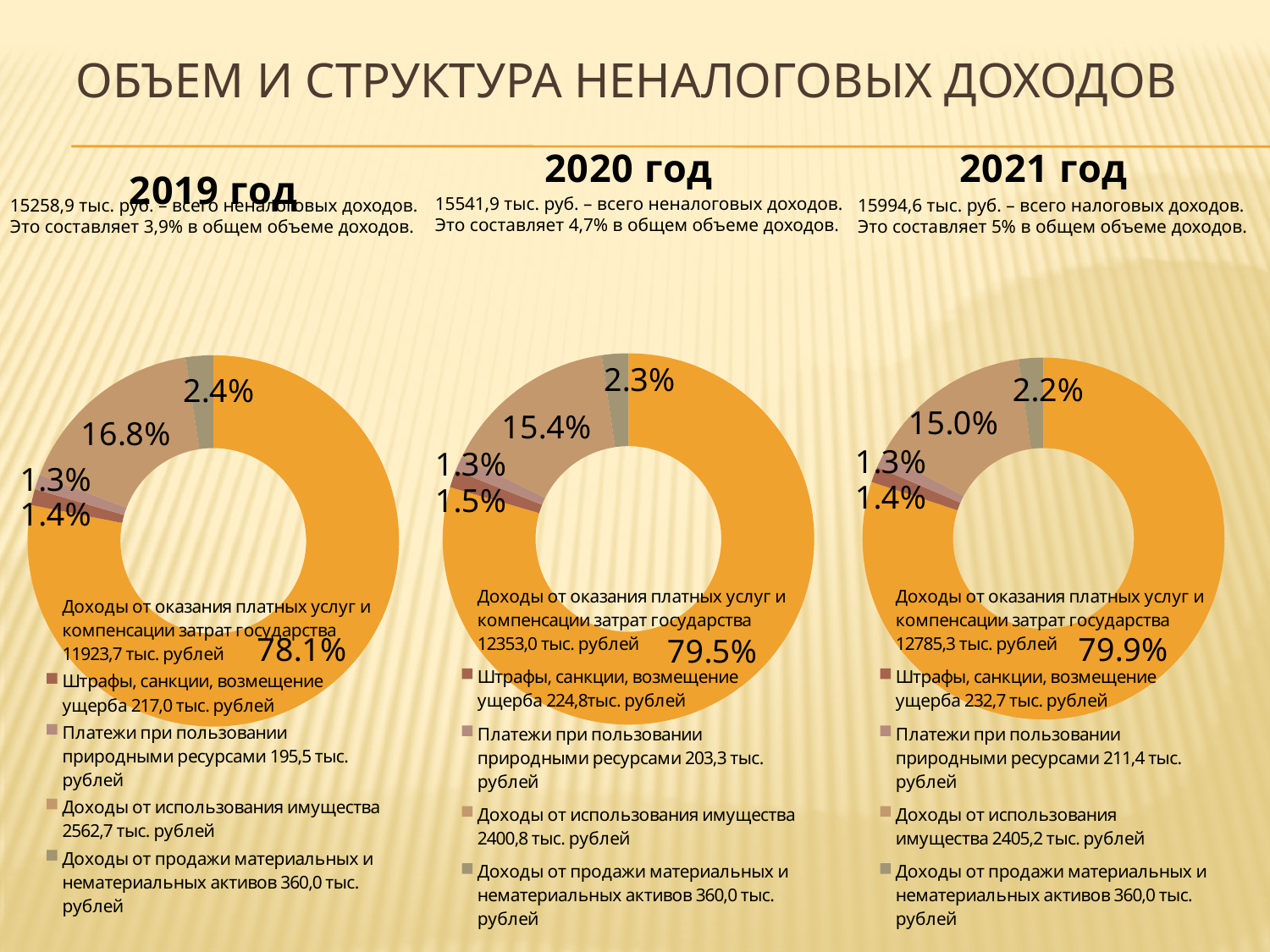
In the 2019 год chart, what is the difference between the shares for Доходы от использования имущества and Доходы от продажи материальных и нематериальных активов? 14.4% In the 2019 год chart, which category has the smallest share? Платежи при пользовании природными ресурсами In the 2020 год chart, which category has the largest share? Доходы от оказания платных услуг и компенсации затрат государства In the 2021 год chart, which is larger: the share for Доходы от использования имущества or the share for Доходы от продажи материальных и нематериальных активов? Доходы от использования имущества In the 2021 год chart, what share is shown for Штрафы, санкции, возмещение ущерба? 1.4% In the 2020 год chart, what share is shown for Доходы от использования имущества? 15.4% In the 2019 год chart, what share is shown for Доходы от оказания платных услуг и компенсации затрат государства? 78.1% What is the title of the slide containing the three charts? ОБЪЕМ И СТРУКТУРА НЕНАЛОГОВЫХ ДОХОДОВ How many entries does the legend of the 2021 год chart list? 5 What kind of chart is used for the 2019 год data? Doughnut (pie) chart In the 2021 год chart, what share is shown for Доходы от продажи материальных и нематериальных активов? 2.2% How many slices does the 2020 год chart have? 5